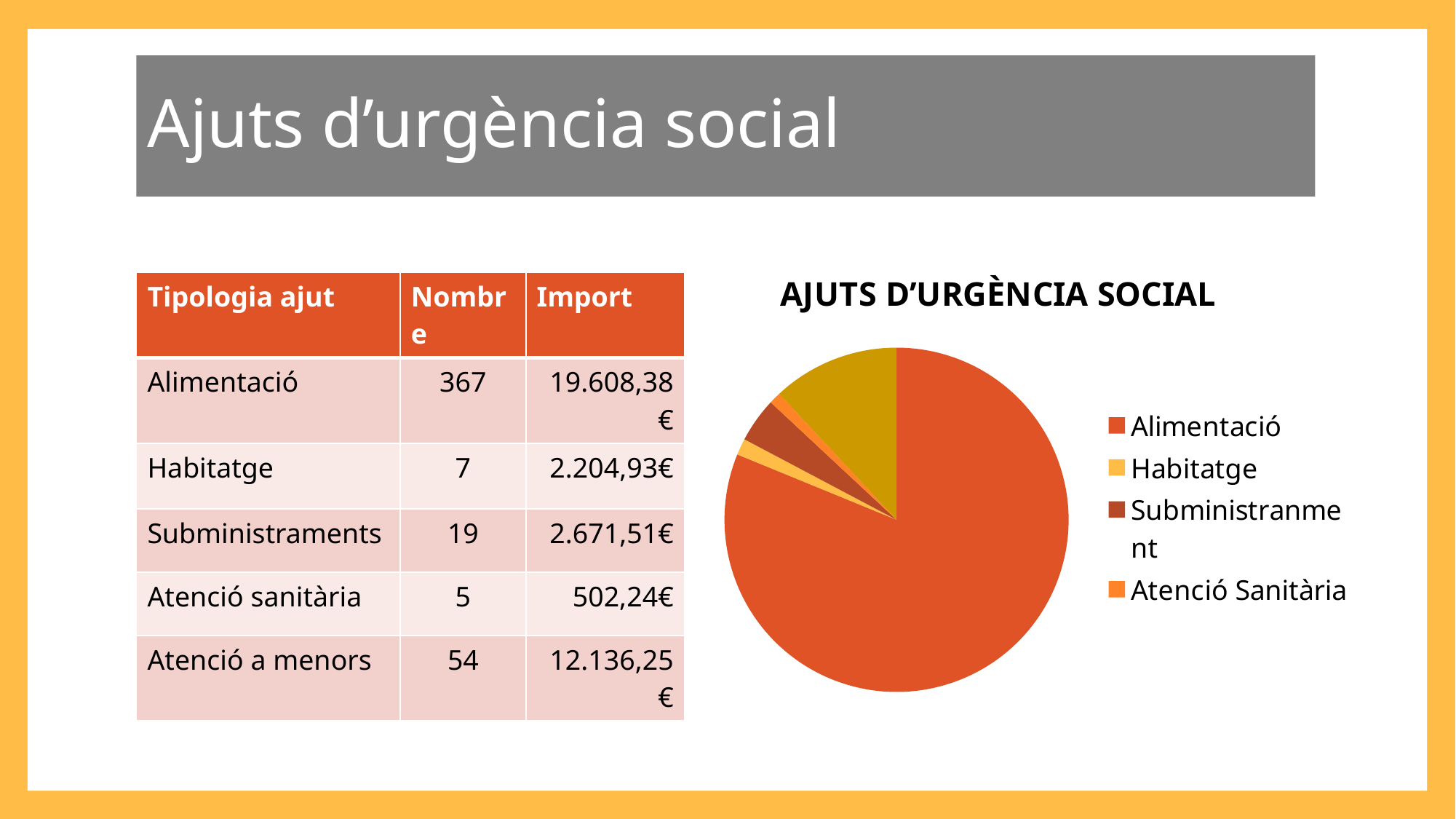
Which slice is larger in the pie chart, Alimentació or Subministranment? Alimentació Which slice is larger in the pie chart, Subministranment or Habitatge? Subministranment Which category has the largest slice in the pie chart? Alimentació How many entries does the chart's legend list? 4 Which slice is larger in the pie chart, Alimentació or Habitatge? Alimentació What colour is the Alimentació slice in the pie chart? red-orange What kind of chart is shown on the slide? pie chart Does the Alimentació slice take up more or less than half of the pie? more What is the title of the chart? AJUTS D'URGÈNCIA SOCIAL